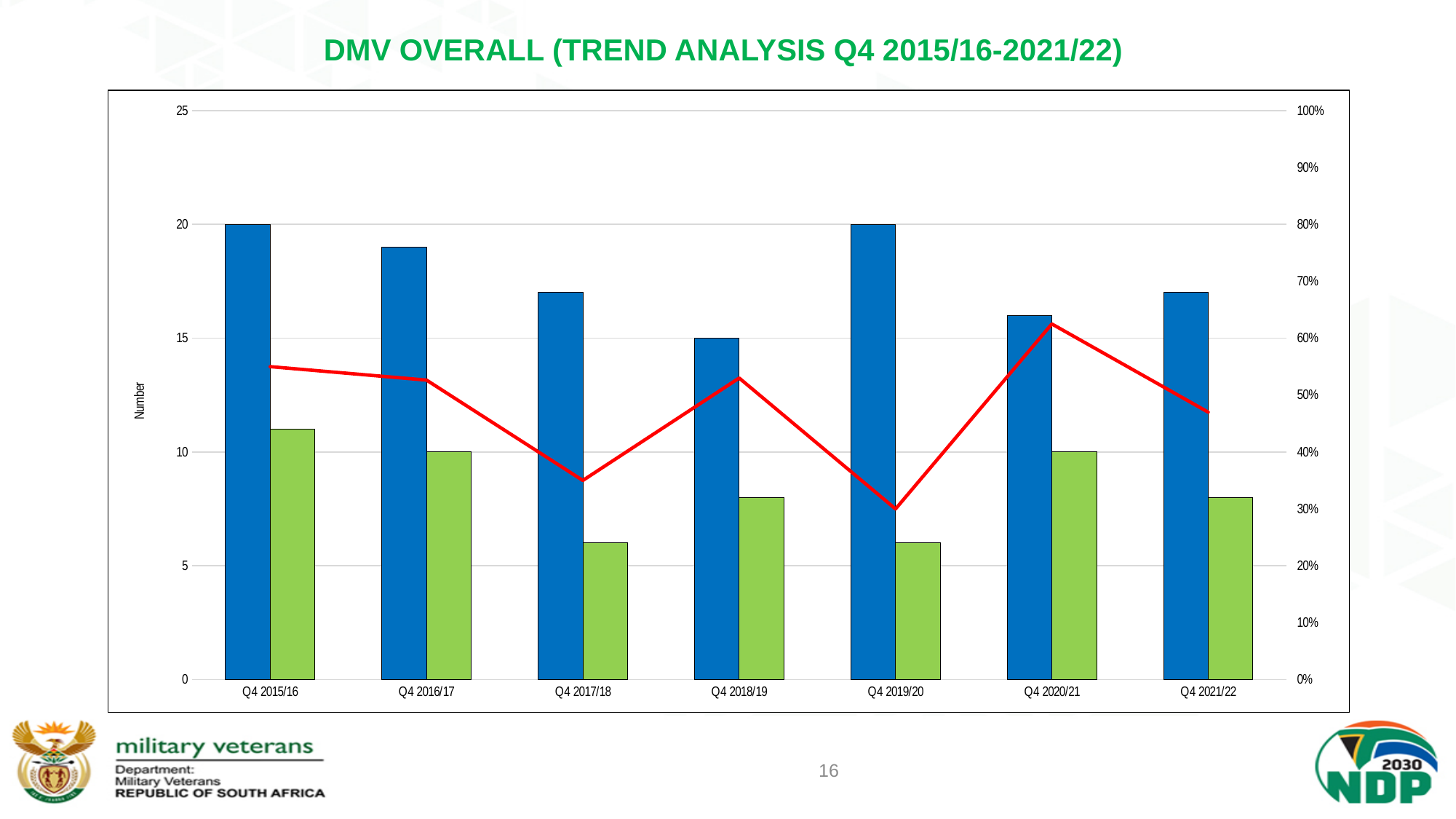
At which quarter does the red line reach its highest point? Q4 2020/21 Which quarter has the lowest blue bar? Q4 2018/19 What is the value of the blue bar for Q4 2015/16? 20 What kind of chart is shown on the slide? A bar chart combined with a line Which is larger, the green bar for Q4 2016/17 or the green bar for Q4 2017/18? Q4 2016/17 Is the value of the green bar for Q4 2015/16 greater or less than 10? greater How many quarters are shown along the x axis? 7 What is the value of the green bar for Q4 2020/21? 10 What is the difference between the blue bars for Q4 2015/16 and Q4 2018/19? 5 At which quarter does the red line reach its lowest point? Q4 2019/20 What is the value of the blue bar for Q4 2018/19? 15 Is the red line value for Q4 2019/20 greater or less than 40%? less